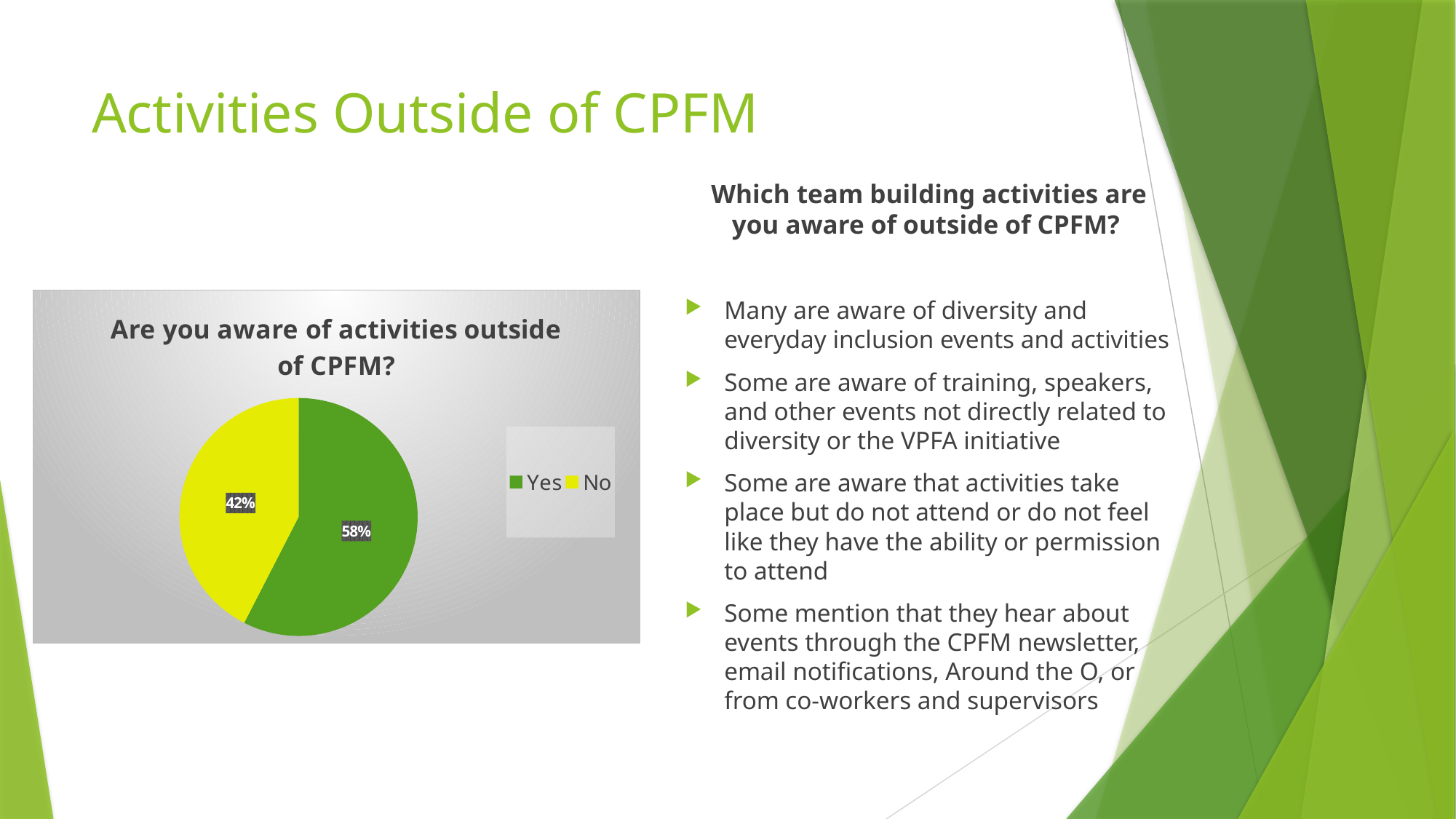
What percentage of respondents answered No to being aware of activities outside of CPFM? 42% What share of the pie does the No slice represent? 42% How many slices does the pie chart have? 2 What percentage of respondents answered Yes to being aware of activities outside of CPFM? 58% Which response has the smaller share of the pie? No What is the difference in percentage points between the Yes and No slices? 16 How many entries does the chart legend list? 2 Which response has the larger share of the pie, Yes or No? Yes What kind of chart is shown on the slide? pie chart Is the share for Yes larger or smaller than the share for No? larger What colour is the Yes slice of the pie chart? green What is the title of the chart? Are you aware of activities outside of CPFM?